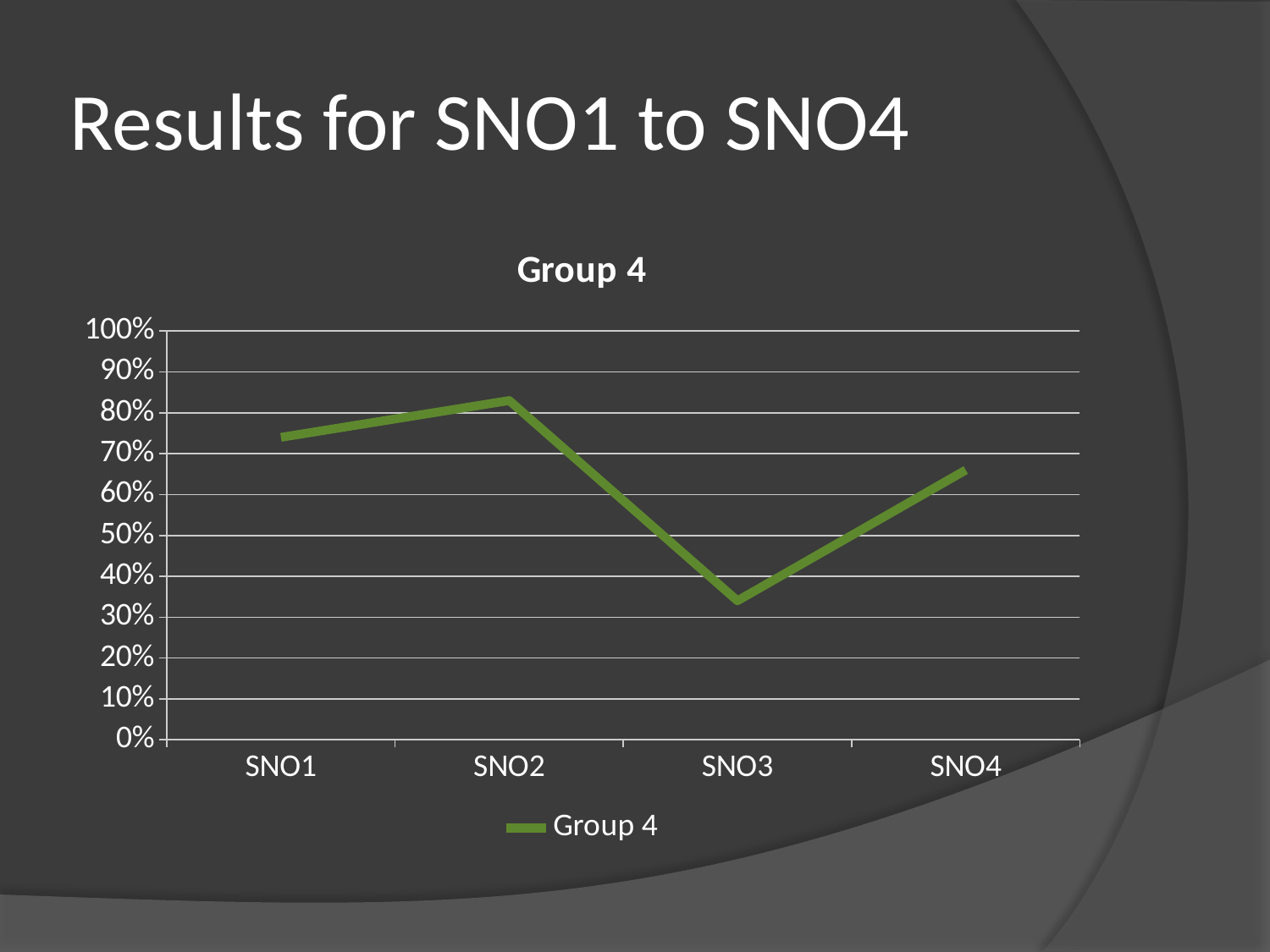
How many series does the legend list? 1 Which is larger, the value for SNO1 or the value for SNO4? SNO1 Is the value for SNO1 greater or less than 60%? greater Which category has the lowest value? SNO3 Which category has the highest value? SNO2 Is the value for SNO3 greater or less than 40%? less Does the value rise or fall from SNO2 to SNO3? fall How many categories are plotted on the x axis? 4 What kind of chart is shown on the slide? line chart Is the value for SNO4 greater or less than 50%? greater What is the title of the chart? Group 4